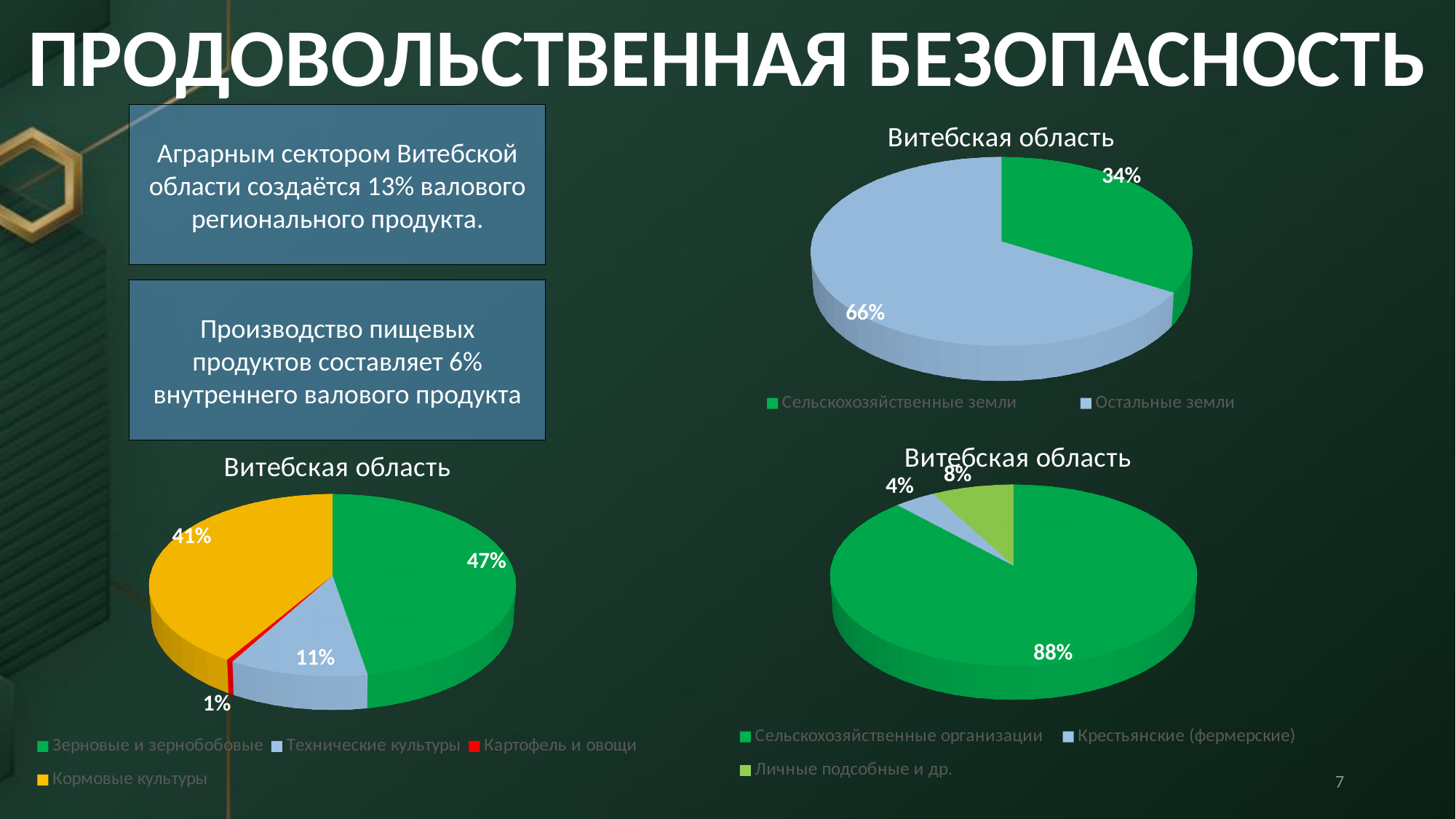
In the bottom-left pie chart, what is the difference between the shares of Зерновые и зернобобовые and Технические культуры? 36% What type of chart is the top-right chart? Pie chart In the bottom-left pie chart, which category has the smallest share? Картофель и овощи In the bottom-right pie chart, which category has the largest share? Сельскохозяйственные организации In the bottom-left pie chart, what share do Зерновые и зернобобовые have? 47% In the bottom-left pie chart, what share do Кормовые культуры have? 41% In the top-right pie chart, what share do Остальные земли have? 66% In the top-right pie chart, how many slices are there? 2 In the bottom-left pie chart, how many categories does the legend list? 4 In the bottom-right pie chart, which is larger: Крестьянские (фермерские) or Личные подсобные и др.? Личные подсобные и др.